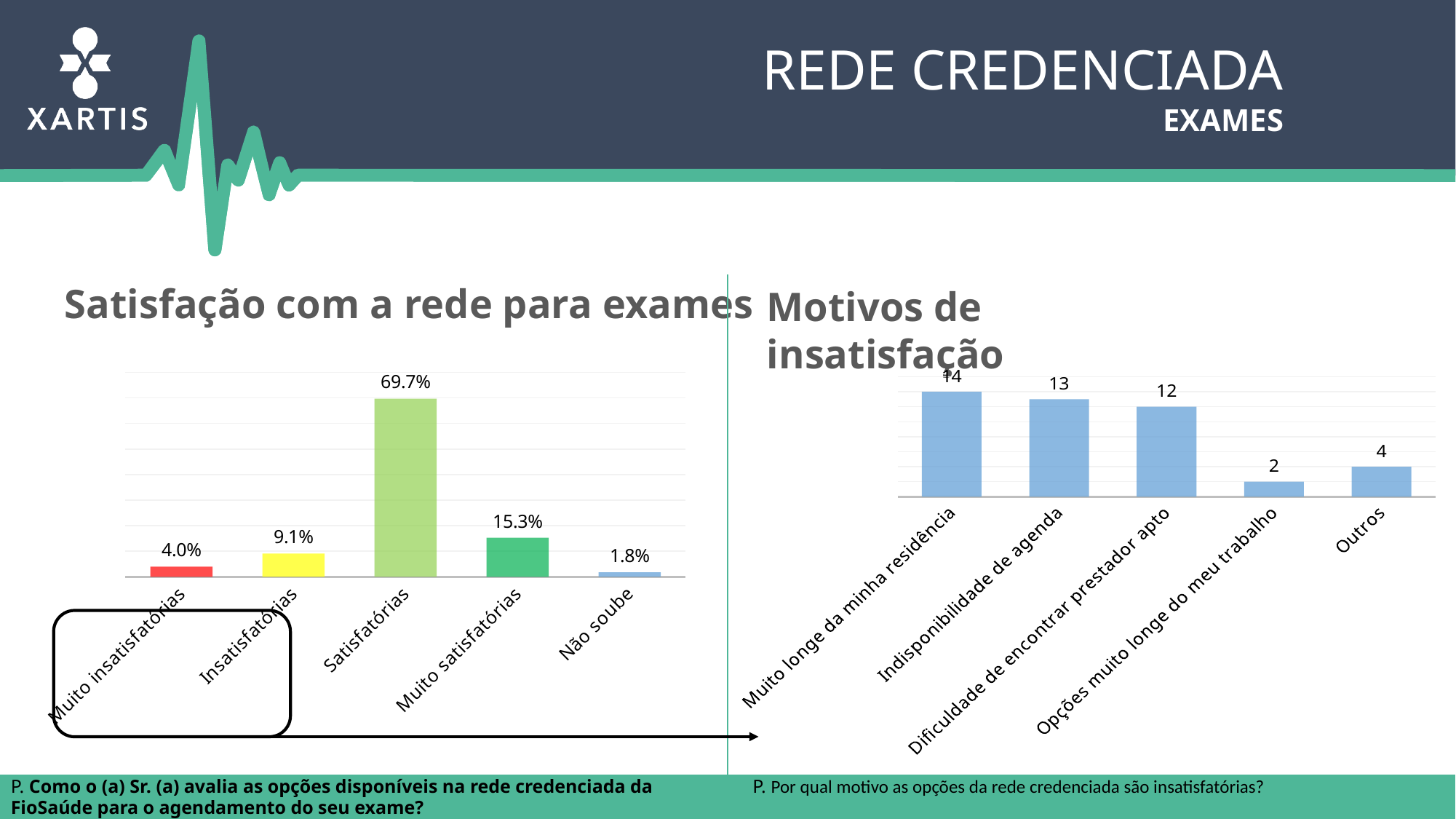
In the 'Satisfação com a rede para exames' chart, what is the combined value of 'Muito insatisfatórias' and 'Insatisfatórias'? 13.1% In the 'Motivos de insatisfação' chart, which category has the highest value? Muito longe da minha residência In the 'Motivos de insatisfação' chart, what is the difference between 'Muito longe da minha residência' and 'Dificuldade de encontrar prestador apto'? 2 In the 'Motivos de insatisfação' chart, what is the value for 'Indisponibilidade de agenda'? 13 In the 'Satisfação com a rede para exames' chart, what is the difference between 'Muito satisfatórias' and 'Insatisfatórias'? 6.2% In the 'Motivos de insatisfação' chart, which is larger: 'Outros' or 'Opções muito longe do meu trabalho'? Outros In the 'Satisfação com a rede para exames' chart, what percentage is shown for 'Satisfatórias'? 69.7% In the 'Satisfação com a rede para exames' chart, what percentage is shown for 'Muito insatisfatórias'? 4.0% In the 'Satisfação com a rede para exames' chart, how many categories are shown? 5 What type of chart is the 'Motivos de insatisfação' chart? Bar chart In the 'Satisfação com a rede para exames' chart, which category has the lowest value? Não soube In the 'Motivos de insatisfação' chart, which category has the lowest value? Opções muito longe do meu trabalho